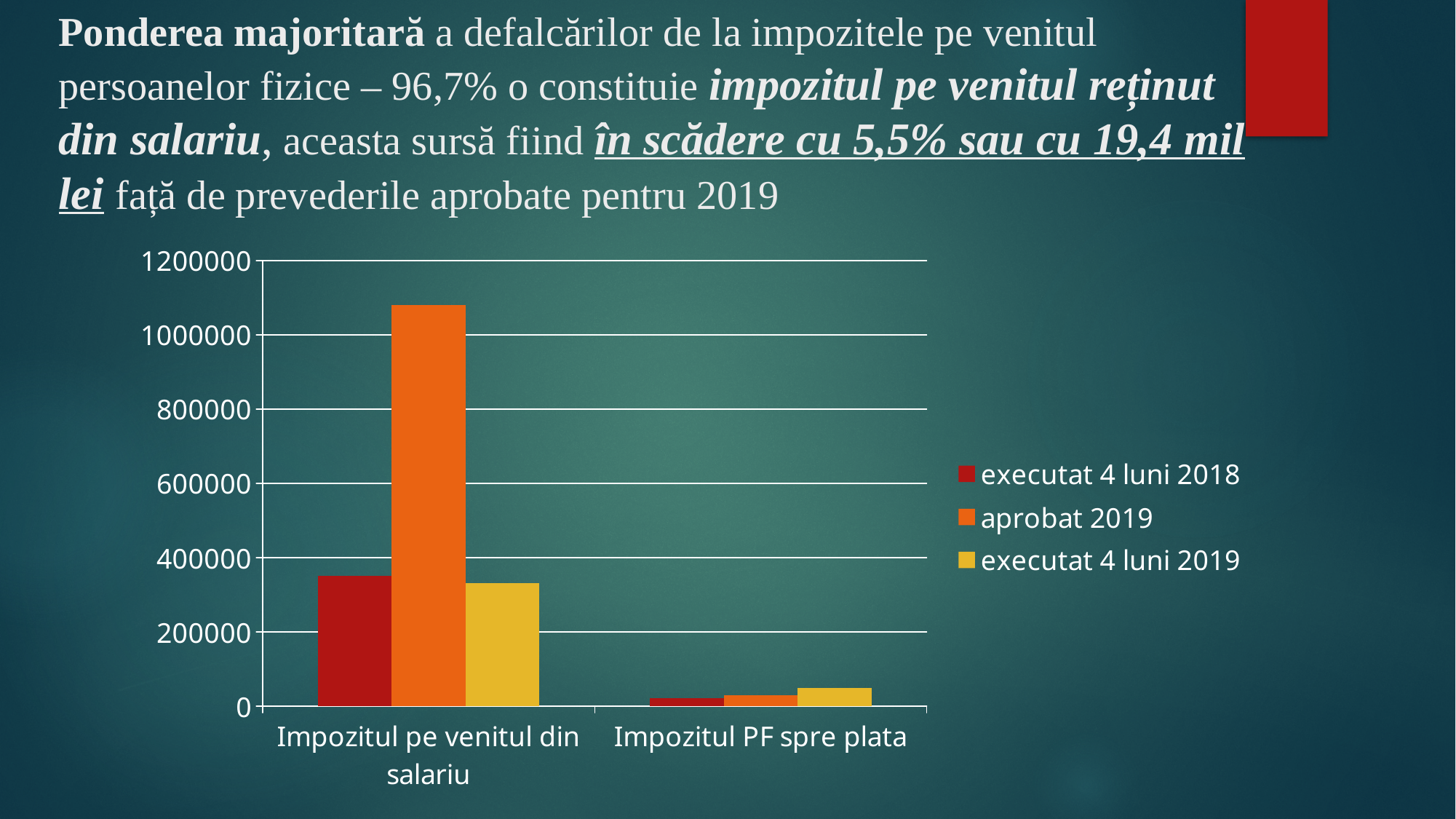
For Impozitul PF spre plata, which is larger: executat 4 luni 2018 or executat 4 luni 2019? executat 4 luni 2019 What colour represents the aprobat 2019 series in the chart? orange Which series has the highest value for Impozitul PF spre plata? executat 4 luni 2019 How many categories are shown on the x axis of the chart? 2 Which series has the highest value for Impozitul pe venitul din salariu? aprobat 2019 Which series has the lowest value for Impozitul PF spre plata? executat 4 luni 2018 What kind of chart is shown on the slide? bar chart How many series does the chart's legend list? 3 Is the executat 4 luni 2019 value for Impozitul PF spre plata greater or less than 200000? less Is the executat 4 luni 2018 value for Impozitul pe venitul din salariu greater or less than 400000? less Which category has the larger aprobat 2019 value, Impozitul pe venitul din salariu or Impozitul PF spre plata? Impozitul pe venitul din salariu Is the aprobat 2019 value for Impozitul pe venitul din salariu greater or less than 1000000? greater